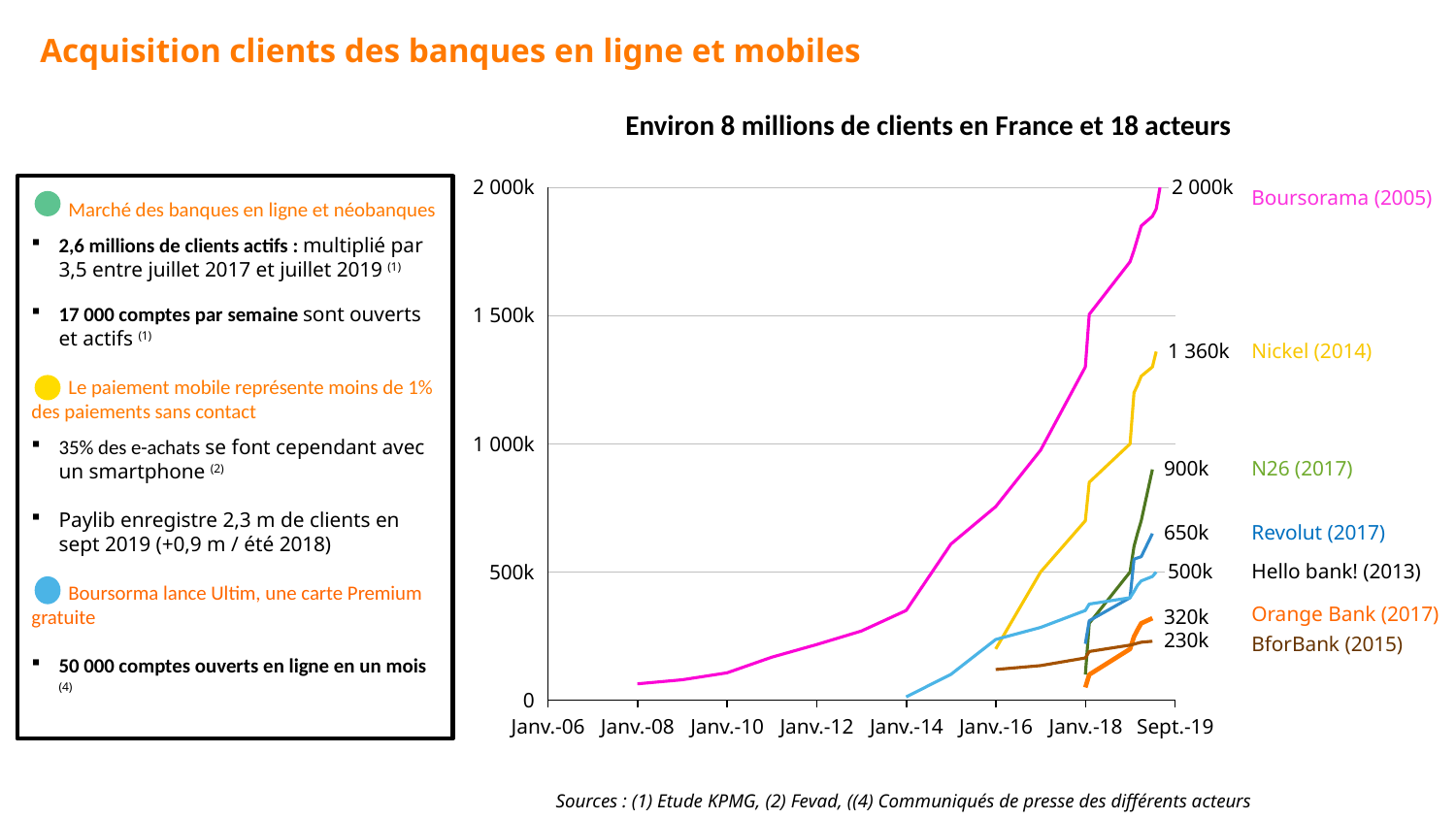
What is the difference between the final values of Nickel (2014) and N26 (2017)? 460k Which has a larger final value, Orange Bank (2017) or Hello bank! (2013)? Hello bank! (2013) What is the final value shown for Revolut (2017)? 650k Which bank has the highest final value on the chart? Boursorama (2005) What is the final value shown for N26 (2017)? 900k What is the final value shown for BforBank (2015)? 230k What is the final value shown for Nickel (2014)? 1 360k What is the title of the chart? Environ 8 millions de clients en France et 18 acteurs What is the final value shown for Boursorama (2005)? 2 000k What type of chart is shown on the slide? line chart Which bank has the lowest final value on the chart? BforBank (2015) How many bank series are plotted on the chart? 7